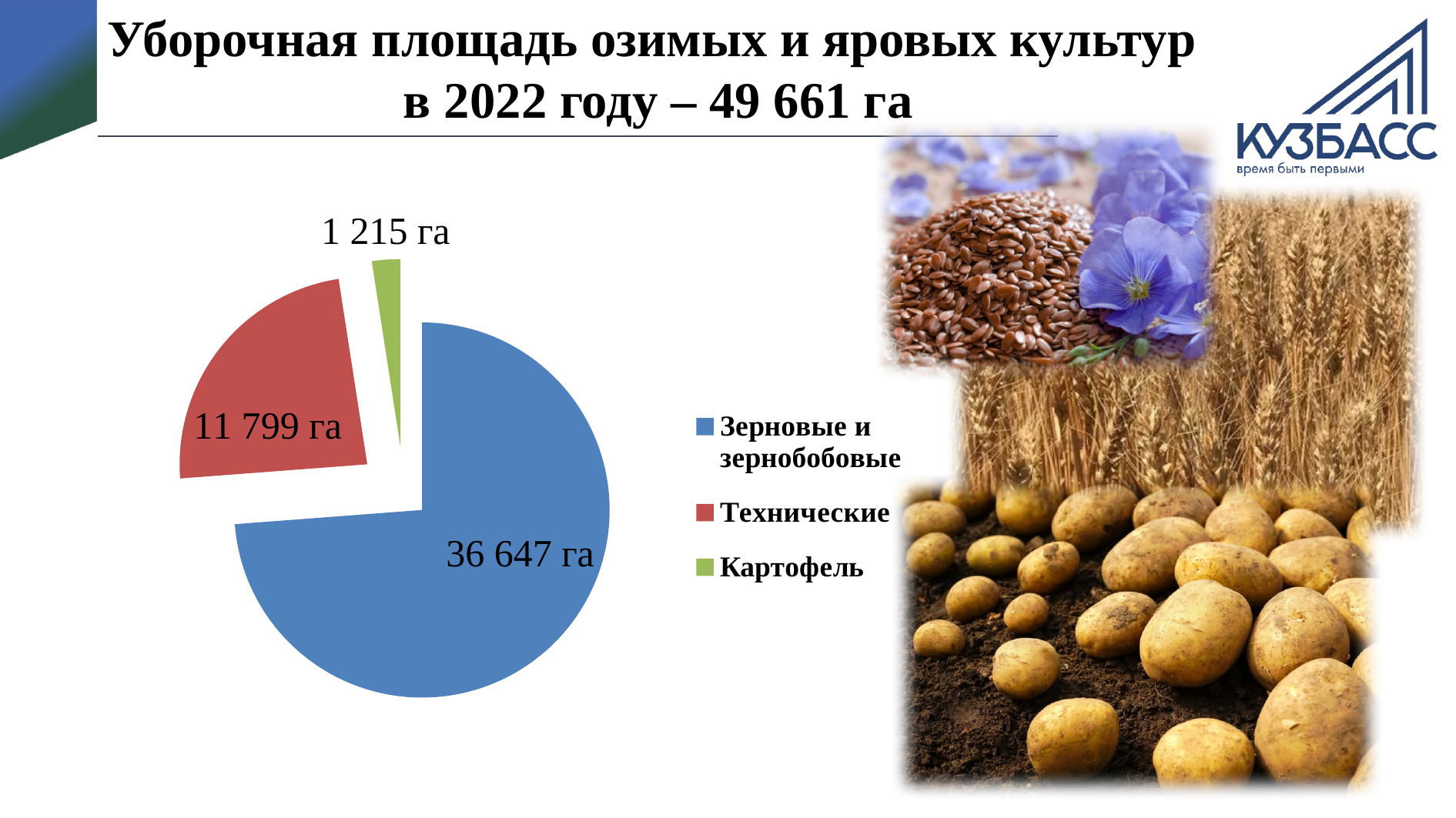
What is the difference between the values for Зерновые и зернобобовые and Технические? 24 848 га Which is larger, the value for Технические or the value for Картофель? Технические Which category has the smallest slice of the pie? Картофель Which category has the largest slice of the pie? Зерновые и зернобобовые What kind of chart is shown on the slide? Pie chart What is the difference between the values for Технические and Картофель? 10 584 га What is the value for Технические? 11 799 га How many categories does the pie chart show? 3 What is the total of all three slices of the pie chart? 49 661 га What is the value for Картофель? 1 215 га What is the value for Зерновые и зернобобовые? 36 647 га What colour is the slice for Картофель? Green